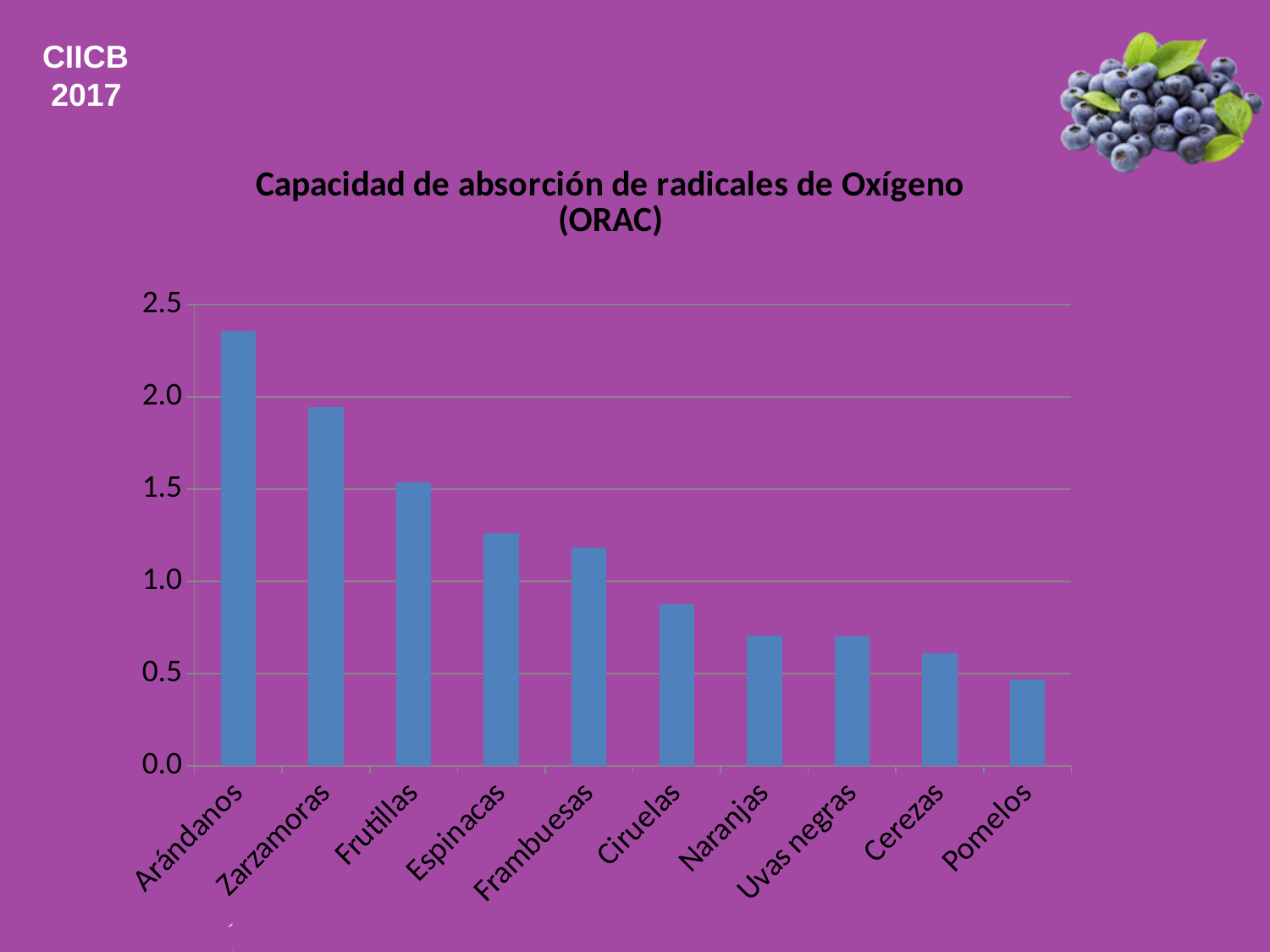
Is the value for Espinacas greater or less than 1.5? less How many categories are plotted in the chart? 10 Which category has the lowest value in the chart? Pomelos Which category has the highest value in the chart? Arándanos What kind of chart is shown on the slide? bar chart Do the values rise or fall from left to right along the x axis? fall Which has a larger value, Zarzamoras or Frutillas? Zarzamoras Which has a larger value, Ciruelas or Cerezas? Ciruelas What is the title of the chart? Capacidad de absorción de radicales de Oxígeno (ORAC) Is the value for Arándanos greater or less than 2.0? greater